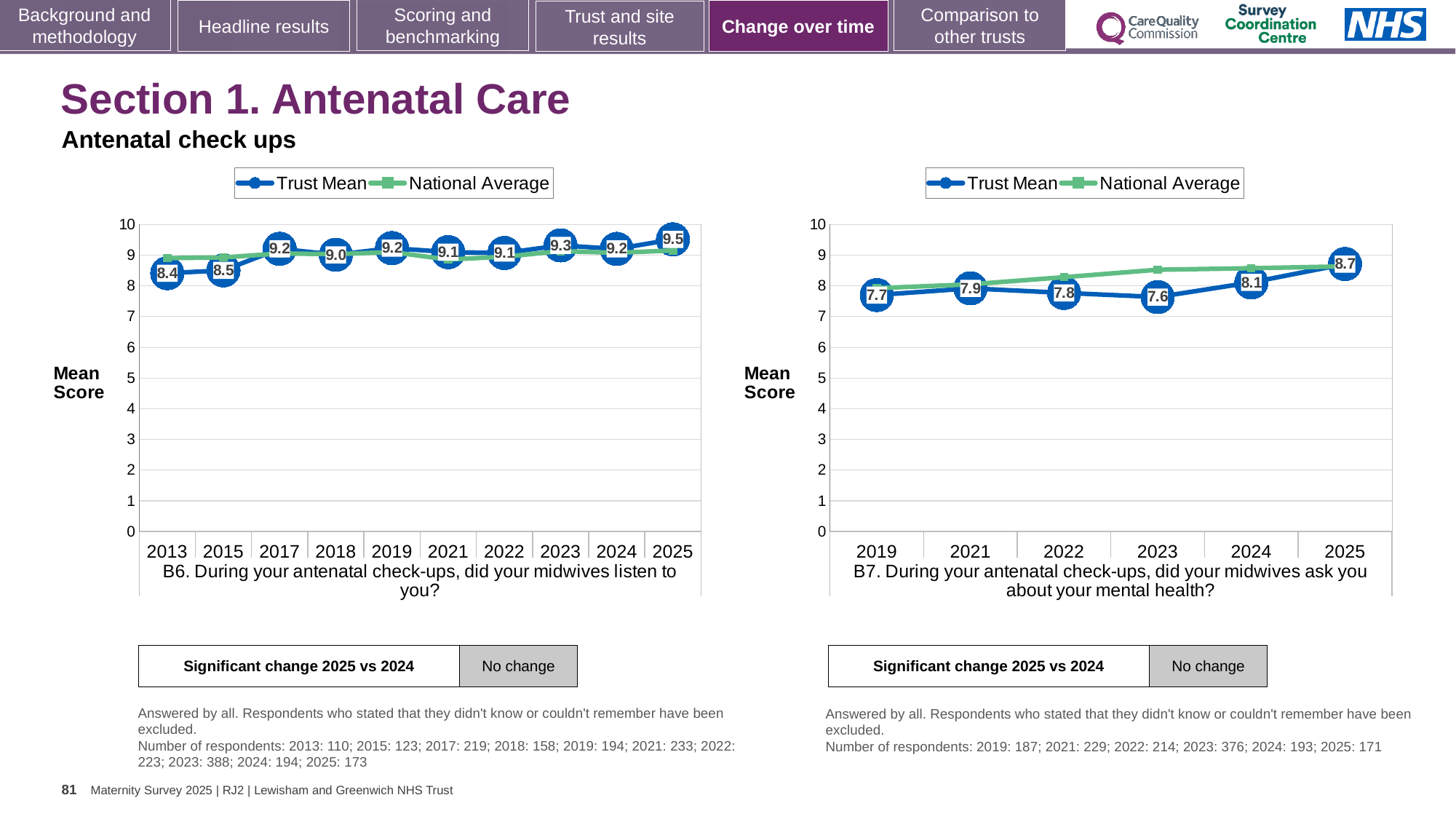
In the right chart (B7), is the Trust Mean score for 2024 larger or smaller than the score for 2023? larger In the right chart (B7), what is the Trust Mean score for 2023? 7.6 In the left chart (B6), what is the difference between the Trust Mean scores for 2025 and 2024? 0.3 In the right chart (B7), how many series does the legend list? 2 In the right chart (B7), what is the difference between the Trust Mean scores for 2025 and 2019? 1.0 In the left chart (B6), how many years are shown on the x axis? 10 What kind of chart is the right chart (B7)? line chart In the left chart (B6), what is the Trust Mean score for 2013? 8.4 In the right chart (B7), which year has the highest Trust Mean score? 2025 In the left chart (B6), what is the Trust Mean score for 2025? 9.5 In the left chart (B6), which year has the highest Trust Mean score? 2025 In the left chart (B6), which year has the lowest Trust Mean score? 2013